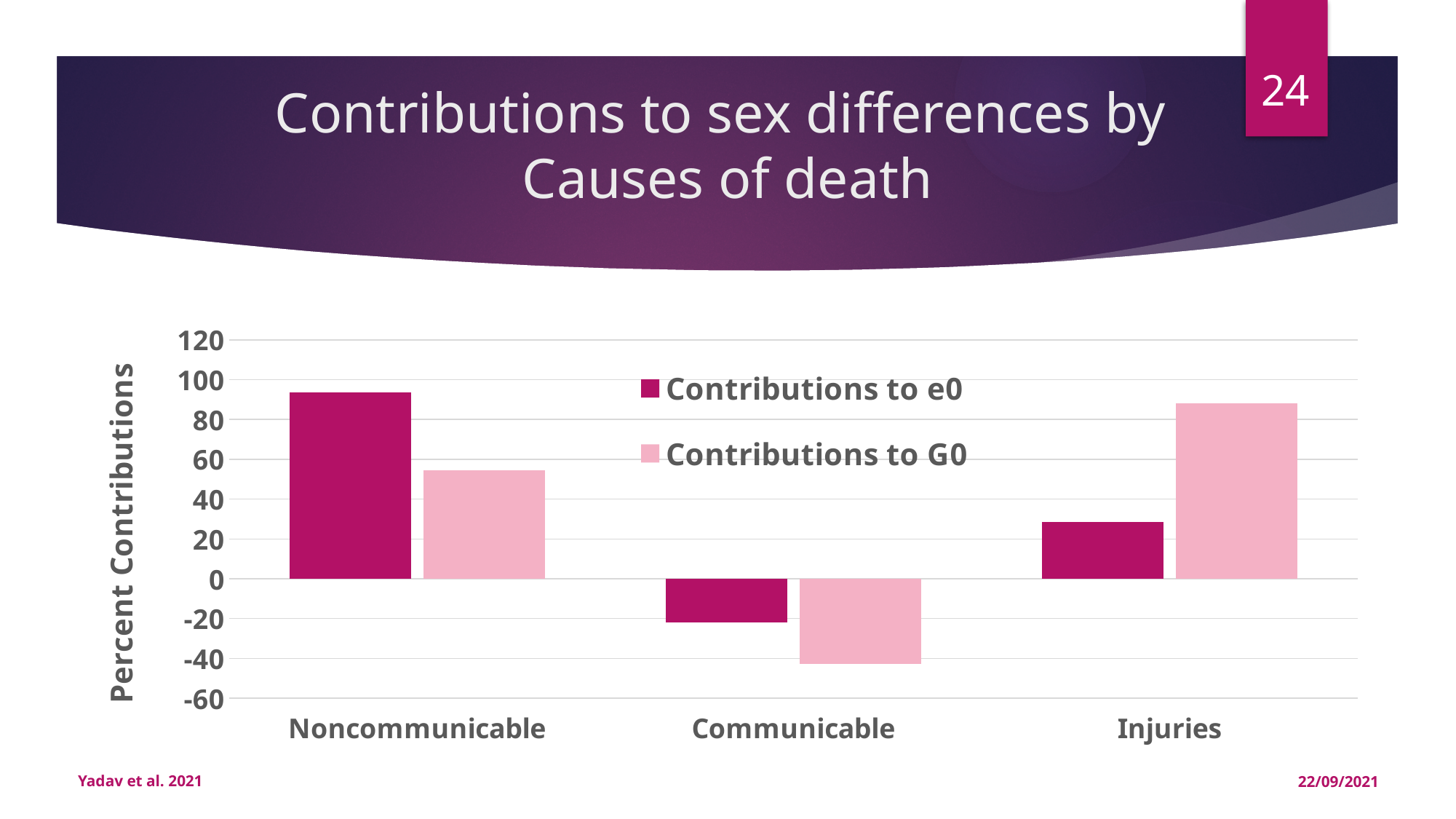
For Noncommunicable, which series has the larger value: Contributions to e0 or Contributions to G0? Contributions to e0 How many categories are shown on the x axis of the chart? 3 Which category has the lowest value for Contributions to G0? Communicable Which category has the highest value for Contributions to G0? Injuries What is the title of the chart's vertical axis? Percent Contributions Is the value for Contributions to e0 in the Noncommunicable category greater or less than 80? greater What kind of chart is shown on the slide? bar chart Is the value for Contributions to G0 in the Communicable category greater or less than -20? less How many series does the chart's legend list? 2 Which category has the highest value for Contributions to e0? Noncommunicable What is the title of the slide? Contributions to sex differences by Causes of death For Injuries, which series has the larger value: Contributions to e0 or Contributions to G0? Contributions to G0